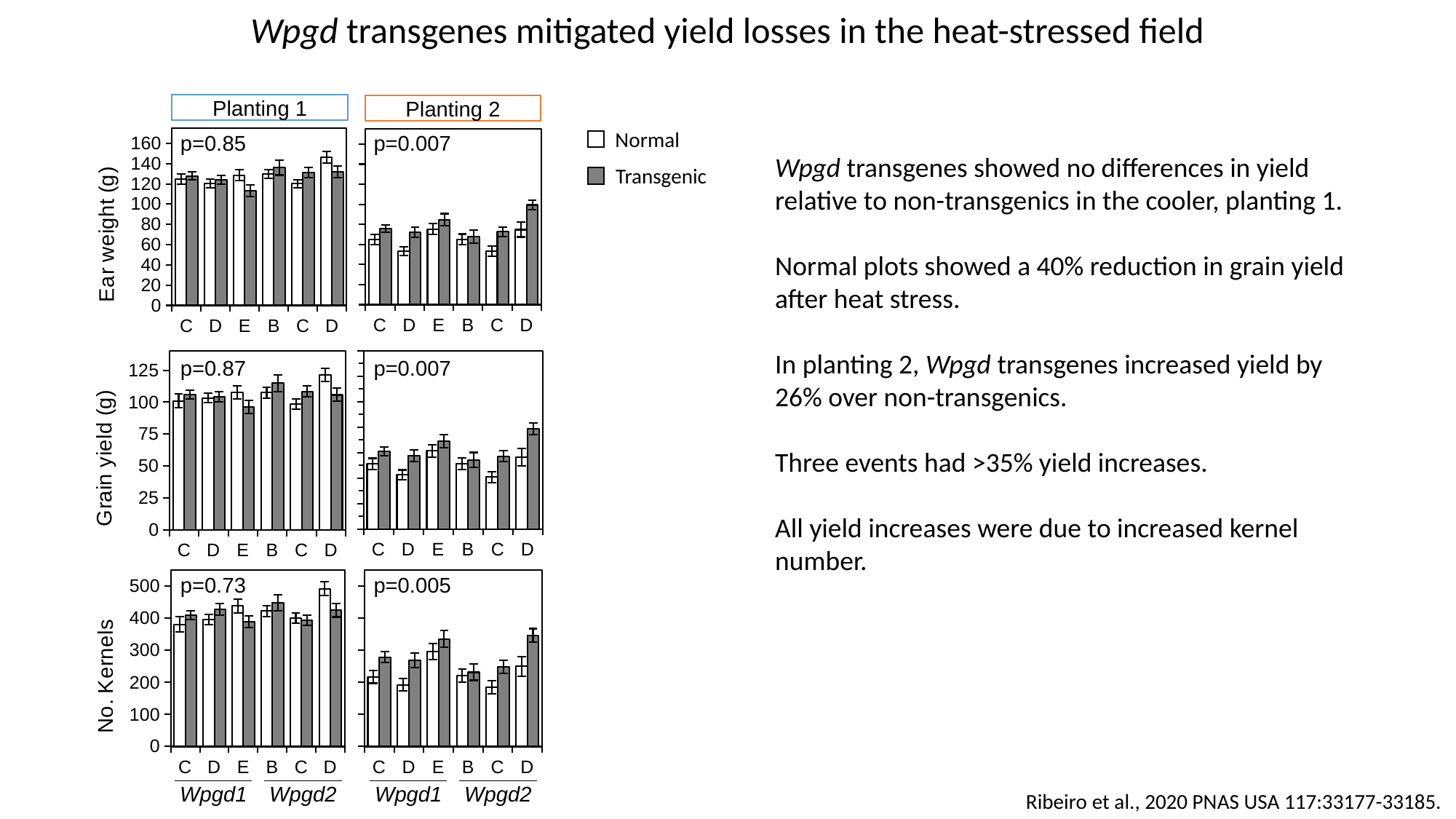
What kind of chart is used in the Ear weight (g) panel for Planting 1? bar chart In the Ear weight (g) chart for Planting 2, is the Transgenic value for Wpgd2 event D greater or less than 80? greater In the Grain yield (g) chart for Planting 2, how many event labels are shown along the x axis? 6 How many series does the legend list for the charts? 2 In the Grain yield (g) chart for Planting 1, for Wpgd1 event E, which is larger: the Normal or the Transgenic bar? Normal In the Ear weight (g) chart for Planting 1, which event has the tallest Normal bar? Wpgd2 D In the Ear weight (g) chart for Planting 2, is the Normal value for Wpgd1 event D greater or less than 60? less In the Grain yield (g) chart for Planting 1, is the Normal value for Wpgd2 event D greater or less than 100? greater In the Ear weight (g) chart for Planting 2, for Wpgd2 event D, which is larger: the Normal or the Transgenic bar? Transgenic What p-value is printed on the No. Kernels chart for Planting 2? p=0.005